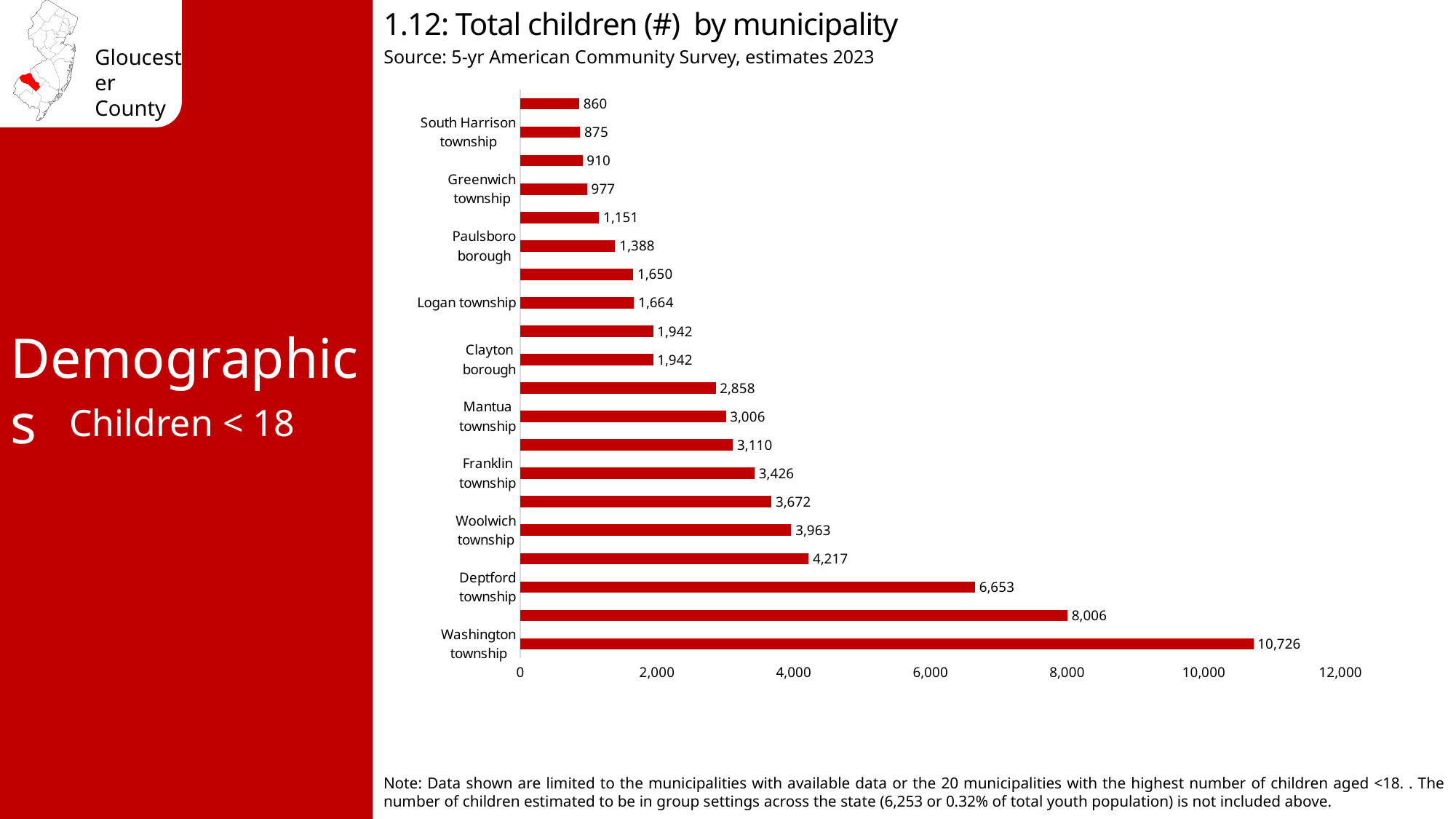
What is the value for Paulsboro borough? 1,388 What is the difference between Washington township and Deptford township? 4,073 What is the value for Woolwich township? 3,963 Which has more children, Franklin township or Mantua township? Franklin township What is the smallest value shown on the chart? 860 What kind of chart is shown? bar chart What is the value for Deptford township? 6,653 Is the value for Logan township greater or less than 2,000? less Which municipality has the highest number of children? Washington township What is the value for Clayton borough? 1,942 How many bars are plotted on the chart? 20 What is the value for Washington township? 10,726